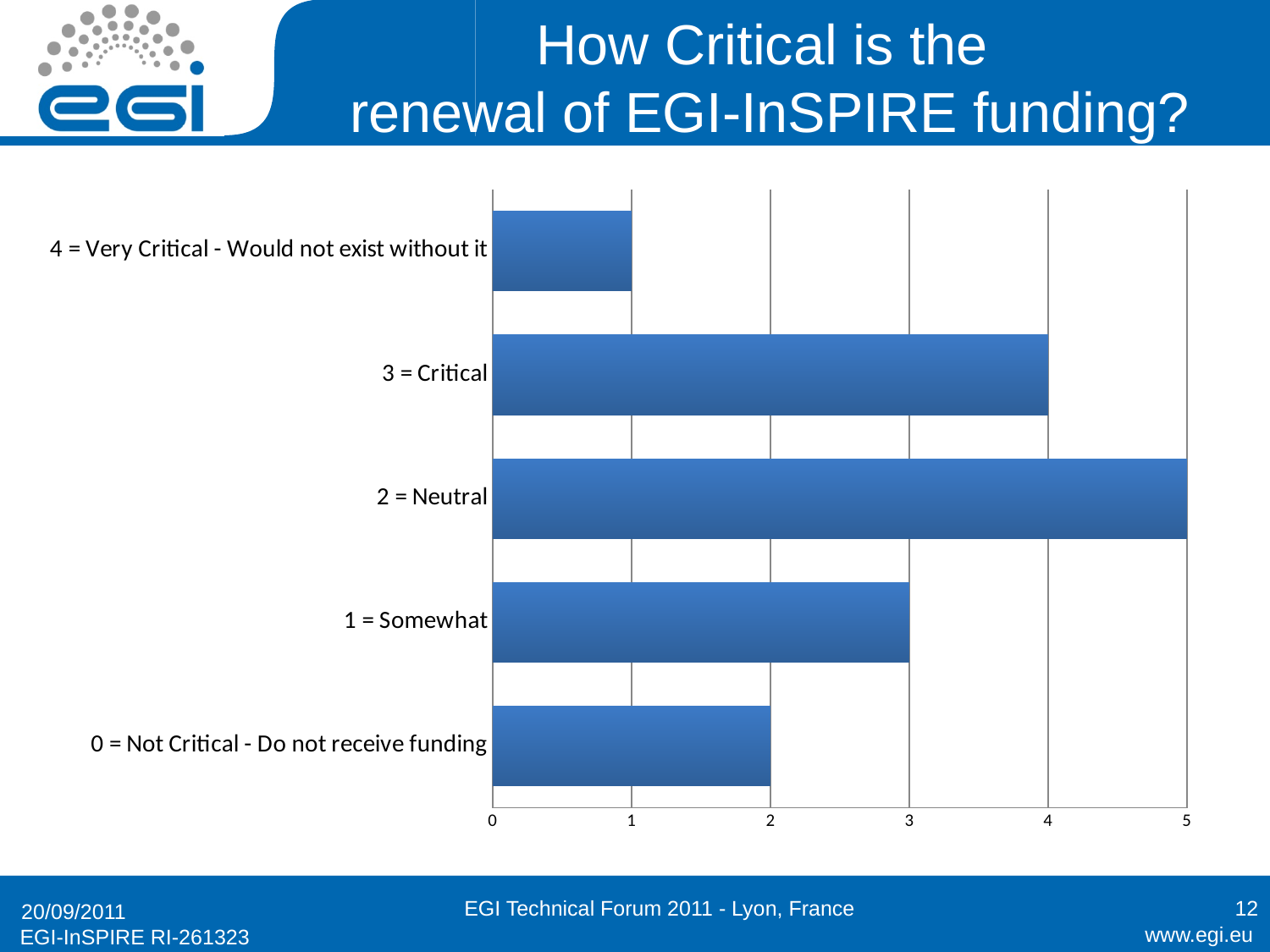
How many categories are plotted in the chart? 5 What is the value for "2 = Neutral"? 5 What is the value for "4 = Very Critical - Would not exist without it"? 1 What is the value for "3 = Critical"? 4 What kind of chart is shown on the slide? bar chart What is the value for "1 = Somewhat"? 3 What is the maximum value shown on the horizontal axis? 5 Which has a larger value, "3 = Critical" or "1 = Somewhat"? 3 = Critical What is the difference between the values for "2 = Neutral" and "4 = Very Critical - Would not exist without it"? 4 Which category has the highest value? 2 = Neutral What is the value for "0 = Not Critical - Do not receive funding"? 2 Which category has the lowest value? 4 = Very Critical - Would not exist without it